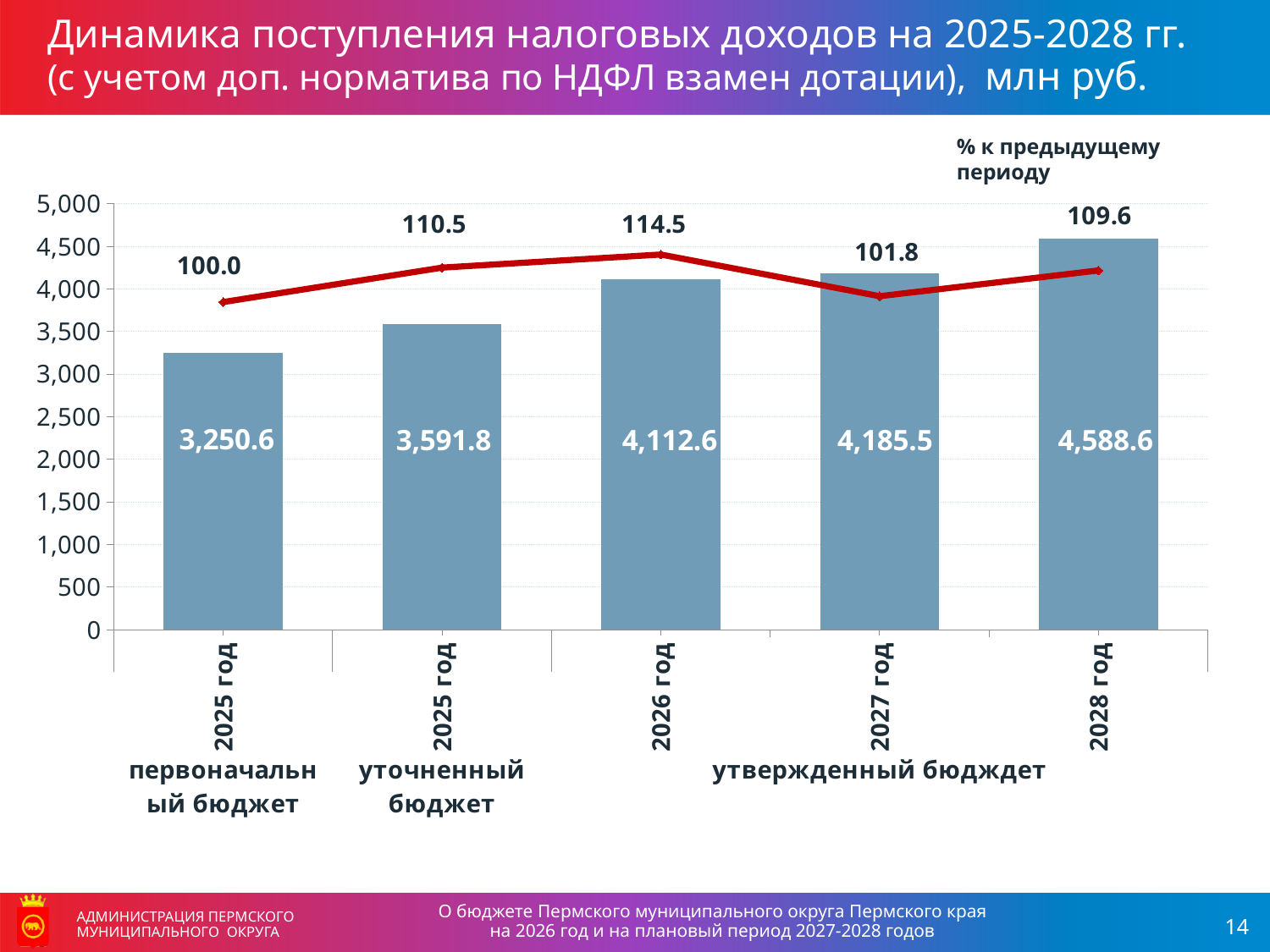
What is the value of the bar for 2025 год (уточненный бюджет)? 3,591.8 Which is larger: the bar value for 2026 год or for 2027 год? 2027 год What is the tax revenue value shown for 2026 год? 4,112.6 What is the difference between the bar values for 2028 год and 2027 год? 403.1 How many bars are plotted on the chart? 5 Do the bar values rise or fall from left to right across the chart? rise What is the '% к предыдущему периоду' value shown for 2028 год? 109.6 What is the value of the bar for 2025 год (первоначальный бюджет)? 3,250.6 Which year has the highest '% к предыдущему периоду' value on the line? 2026 год Which category has the lowest bar value? 2025 год (первоначальный бюджет) What is the '% к предыдущему периоду' value shown for 2027 год? 101.8 Which category has the highest bar value? 2028 год